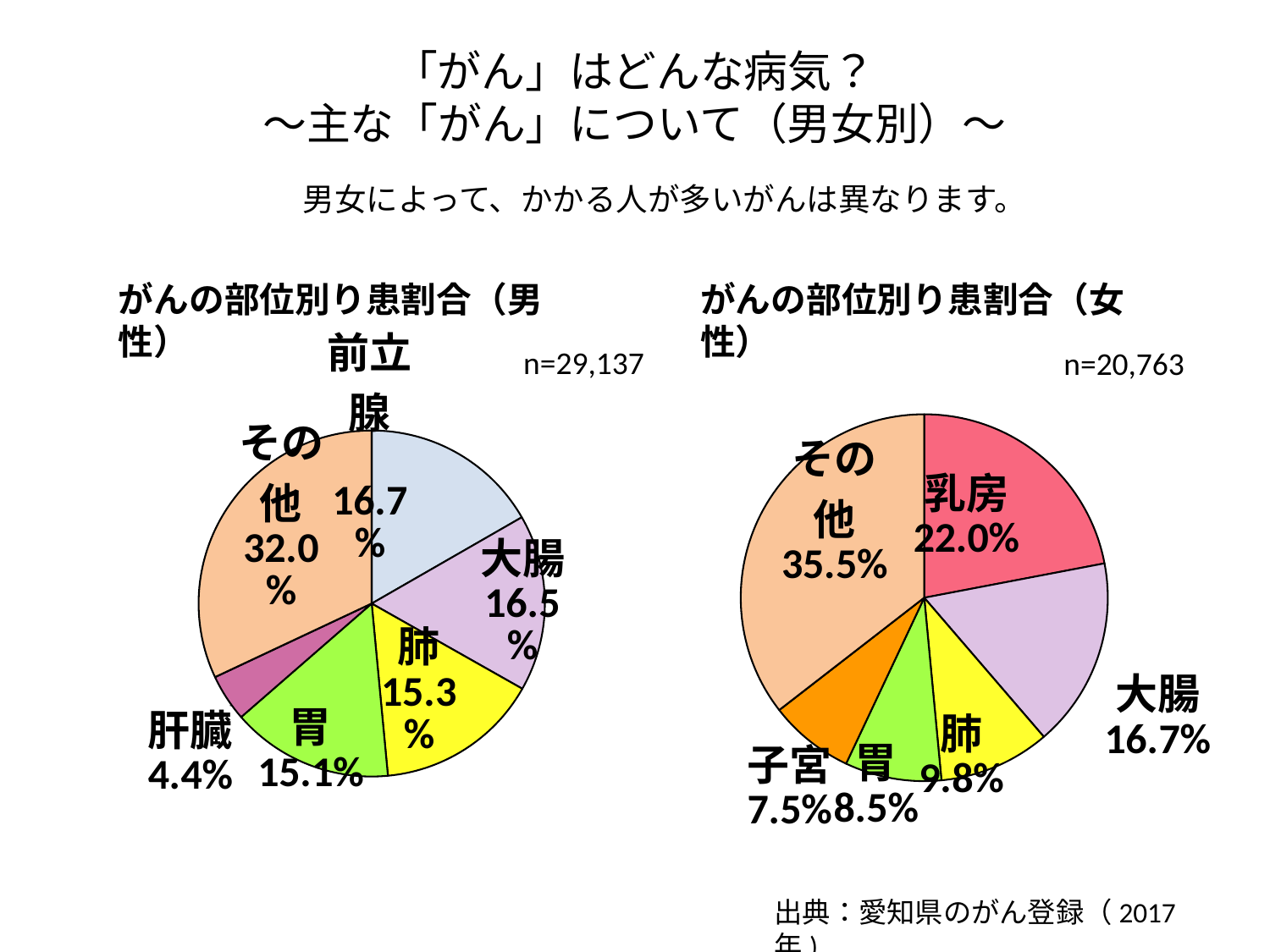
What type of chart is used for the right chart (女性)? Pie chart In the right pie chart (女性), excluding その他, which cancer site has the largest share? 乳房 In the left pie chart (男性), which slice is the smallest? 肝臓 In the right pie chart (女性), what is the share for 子宮? 7.5% In the right pie chart (女性), which slice is the largest? その他 In the right pie chart (女性), what is the difference between the shares for 乳房 and 大腸? 5.3% How many slices does the left pie chart (男性) have? 6 Which is larger: the share for 肺 in the left pie chart (男性) or the share for 肺 in the right pie chart (女性)? 男性 (15.3%) In the left pie chart (男性), what is the share for 肝臓? 4.4% In the left pie chart (男性), what is the difference between the shares for その他 and 前立腺? 15.3% In the left pie chart (がんの部位別り患割合（男性）), what is the share for 前立腺? 16.7% In the right pie chart (がんの部位別り患割合（女性）), what is the share for 乳房? 22.0%